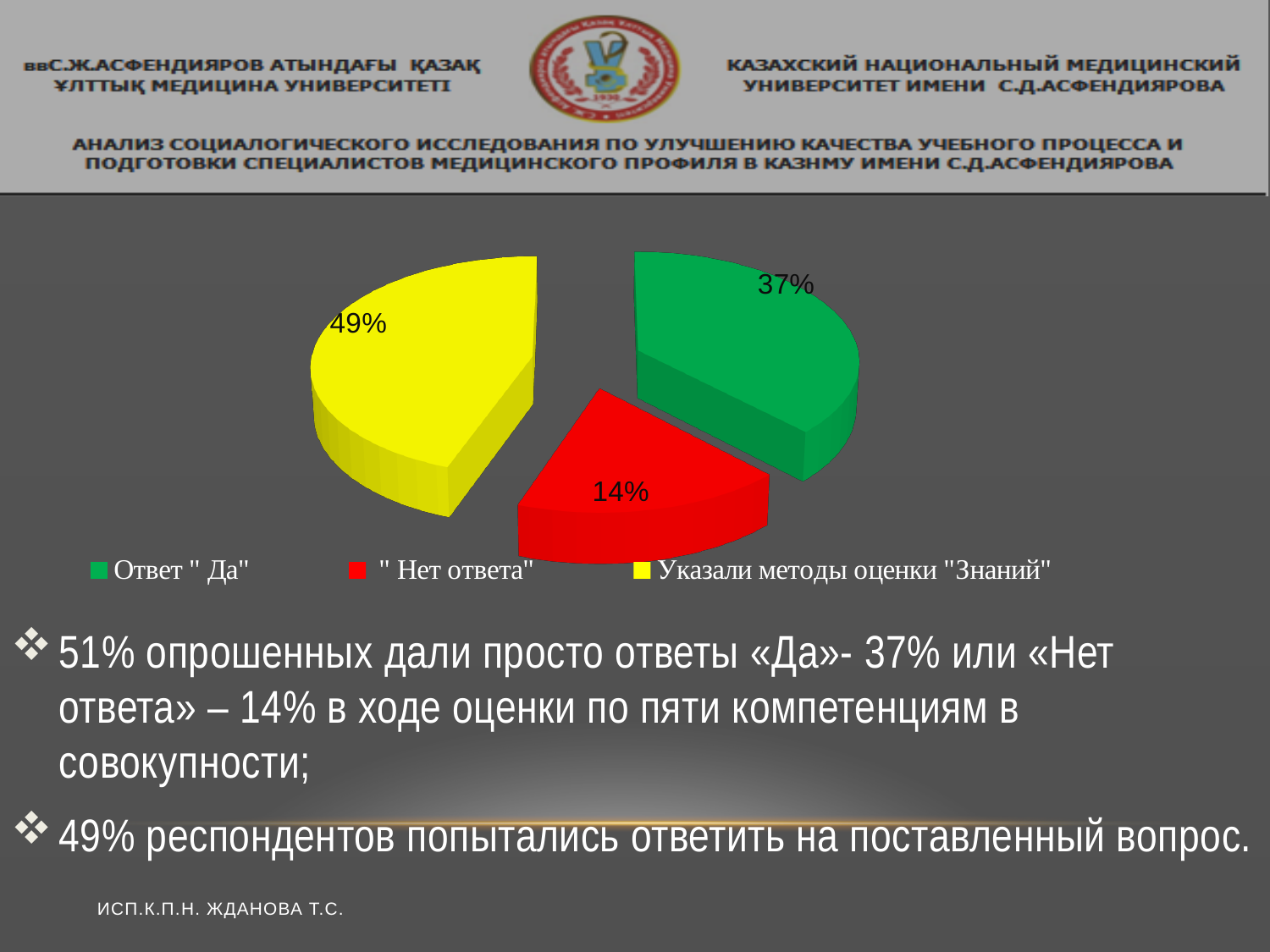
Which is larger: the slice for Ответ "Да" or the slice for Указали методы оценки "Знаний"? Указали методы оценки "Знаний" Which category has the largest slice of the pie? Указали методы оценки "Знаний" How many slices does the pie chart have? 3 What percentage of the pie is labelled for Указали методы оценки "Знаний"? 49% What kind of chart is shown on the slide? pie chart Which category has the smallest slice of the pie? "Нет ответа" What colour is the slice for "Нет ответа"? red What percentage of the pie is labelled for "Нет ответа"? 14% What is the difference in percentage points between the Ответ "Да" slice and the "Нет ответа" slice? 23 What colour is the slice for Указали методы оценки "Знаний"? yellow What percentage of the pie is labelled for Ответ "Да"? 37% How many entries does the legend list? 3